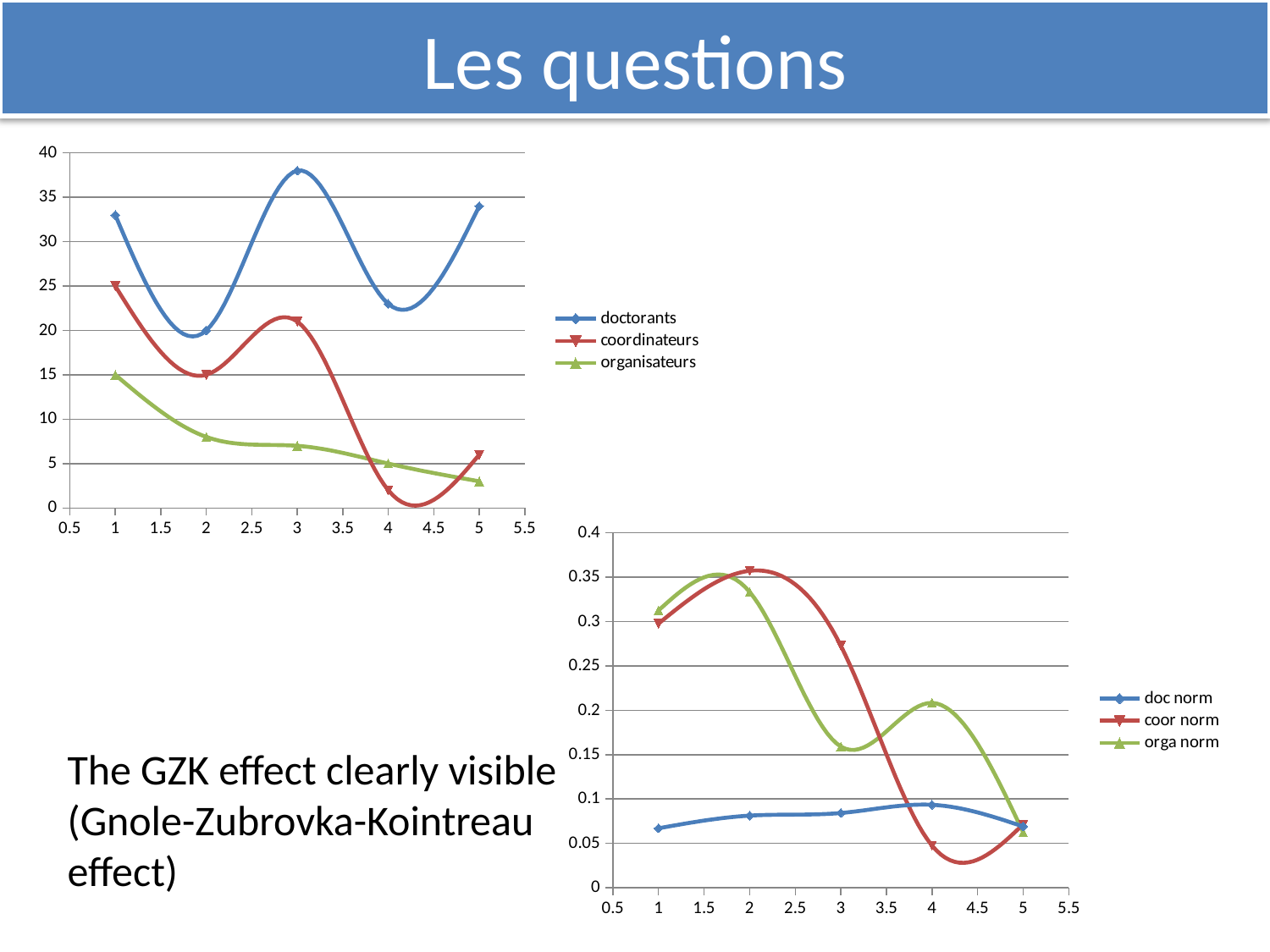
In the top-left chart, which series has the highest value at x = 3? doctorants How many series does the legend of the top-left chart list? 3 In the top-left chart, how many data points does the doctorants series have? 5 What are the legend entries of the bottom-right chart? doc norm, coor norm, orga norm In the top-left chart, is the value for coordinateurs at x = 4 greater or less than 5? less How many series does the legend of the bottom-right chart list? 3 In the top-left chart, at x = 5, which is larger: doctorants or coordinateurs? doctorants In the top-left chart, does the organisateurs series rise or fall from x = 1 to x = 5? fall In the top-left chart, is the value for doctorants at x = 3 greater or less than 35? greater In the bottom-right chart, which series has the lowest value at x = 1? doc norm What kind of chart is the top-left chart on the slide? line chart